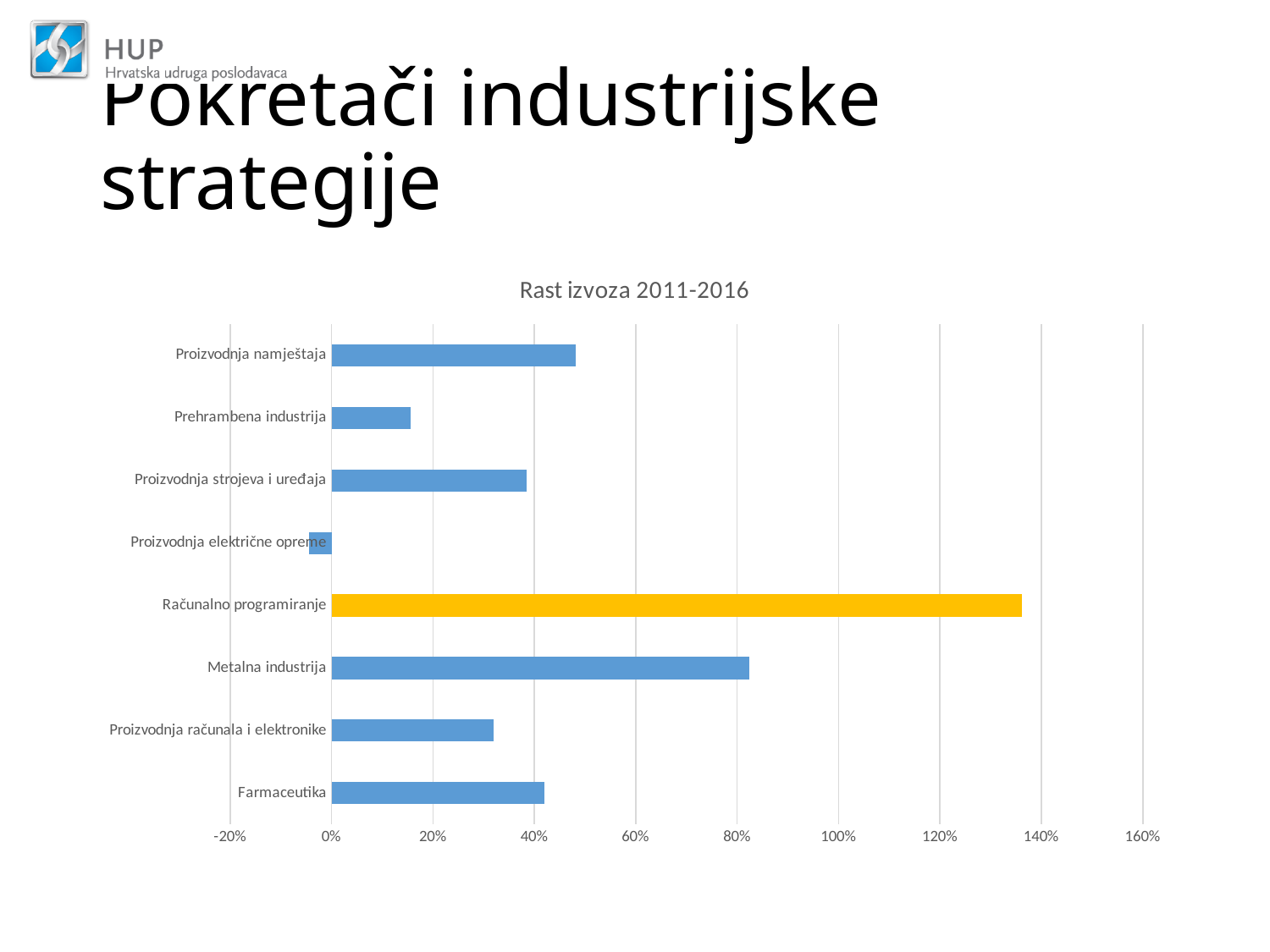
Which category has the lowest value in the chart? Proizvodnja električne opreme What kind of chart is shown on the slide? bar chart Is the value for Računalno programiranje greater or less than 120%? greater Which is larger, the value for Metalna industrija or the value for Farmaceutika? Metalna industrija What is the title of the chart? Rast izvoza 2011-2016 How many categories are plotted in the chart? 8 Is the value for Metalna industrija greater or less than 60%? greater Which category's bar is coloured differently (yellow) from the others? Računalno programiranje Is the value for Proizvodnja električne opreme greater or less than 0%? less Which is larger, the value for Proizvodnja namještaja or the value for Proizvodnja računala i elektronike? Proizvodnja namještaja Which category has the highest value in the chart? Računalno programiranje